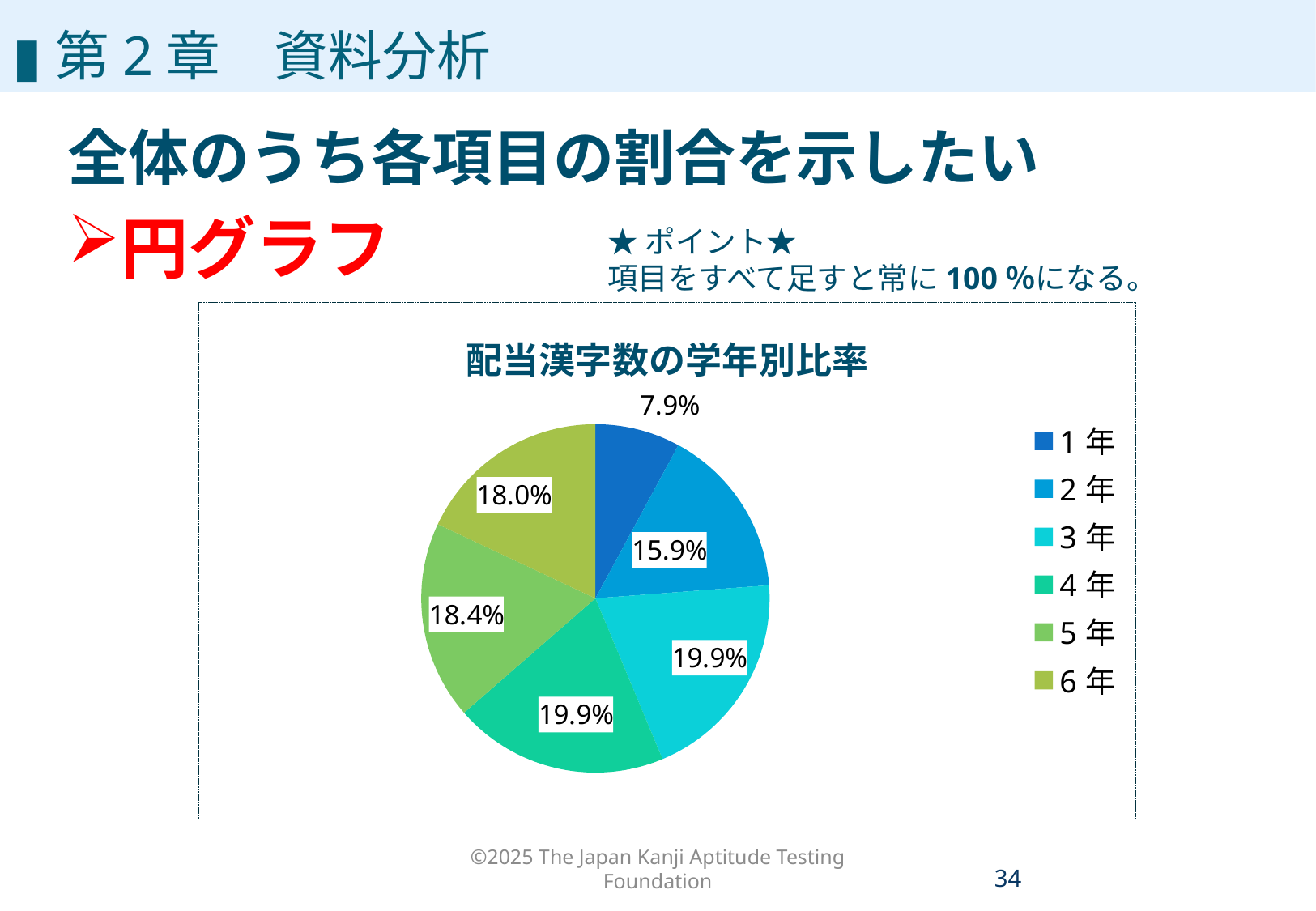
What kind of chart is shown on the slide? pie chart How many entries does the legend list? 6 What percentage of the pie is 5年? 18.4% What percentage of the pie is 1年? 7.9% Which grade has the smallest share of the pie? 1年 What is the title of the chart? 配当漢字数の学年別比率 What is the difference in percentage points between the shares of 5年 and 6年? 0.4 What is the difference in percentage points between the shares of 3年 and 1年? 12.0 What percentage of the pie is 2年? 15.9% How many slices does the pie chart have? 6 What percentage of the pie is 6年? 18.0% Which has the larger share, 2年 or 5年? 5年